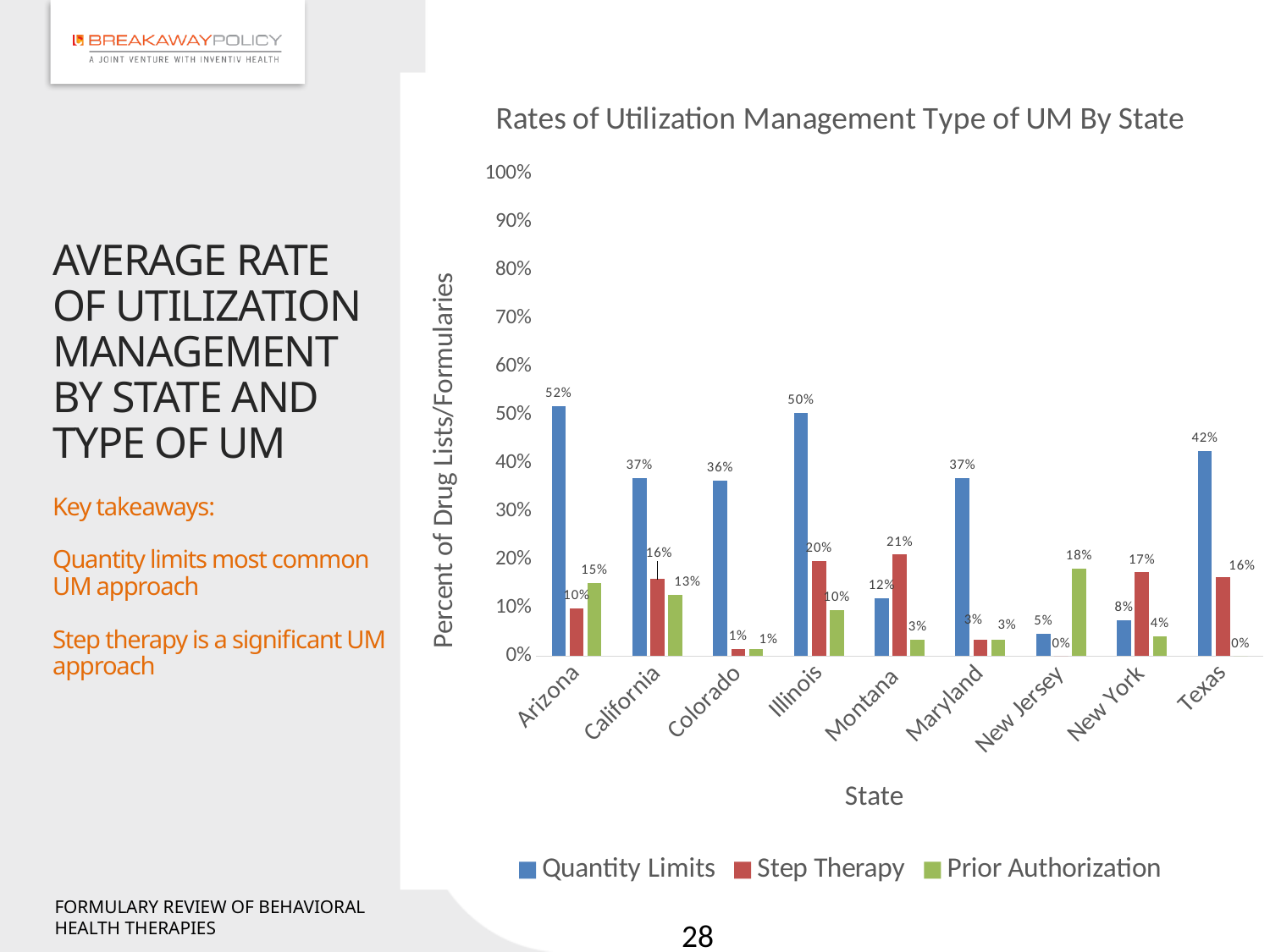
What kind of chart is shown on the slide? Bar chart What is the Prior Authorization value for New Jersey? 18% What is the label of the y axis? Percent of Drug Lists/Formularies Which state has the lowest Quantity Limits value? New Jersey What is the Step Therapy value for Montana? 21% Is the Quantity Limits value for Texas greater or less than 40%? greater How many states are shown on the x axis? 9 What is the Quantity Limits value for Arizona? 52% Which state has the highest Quantity Limits value? Arizona What is the difference between the Quantity Limits value for Illinois and the Quantity Limits value for Texas? 8% Which is larger for Montana: Quantity Limits or Step Therapy? Step Therapy How many series does the legend list? 3